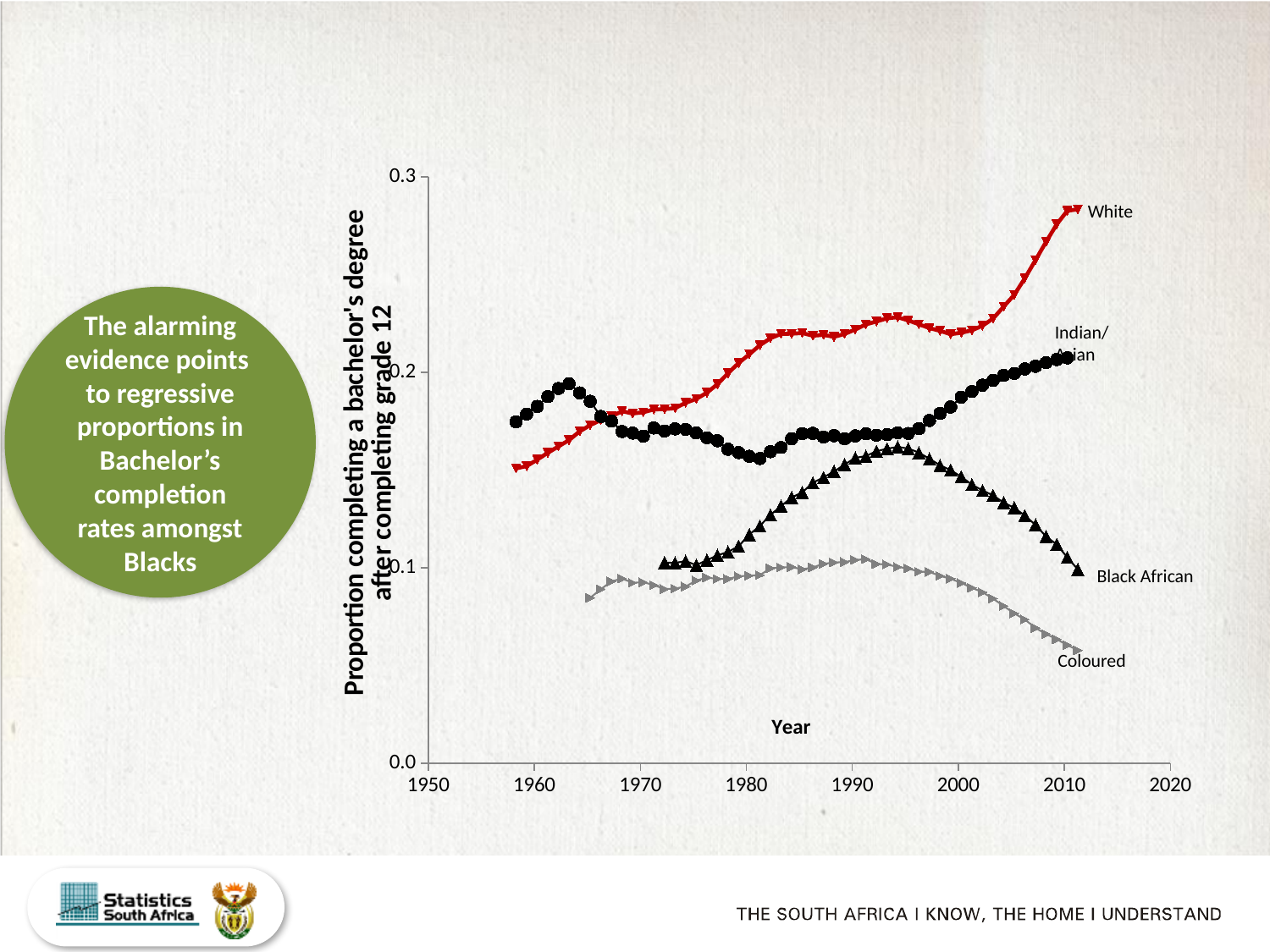
Is the value for White around 2010 greater or less than 0.2? greater Does the Black African series rise or fall between 1995 and 2010? fall What is the title of the horizontal axis? Year Which series has the highest value at the right end of the chart (around 2010)? White Which series has the lowest value at the right end of the chart (around 2010)? Coloured Does the White series rise or fall between 2000 and 2010? rise Is the value for Black African around 1995 greater or less than 0.1? greater Is the value for Coloured around 2010 greater or less than 0.1? less What is the title of the vertical axis? Proportion completing a bachelor's degree after completing grade 12 Around 1960, which series has the higher value, White or Indian/Asian? Indian/Asian What kind of chart is shown on the slide? line chart How many series are labelled on the chart? 4